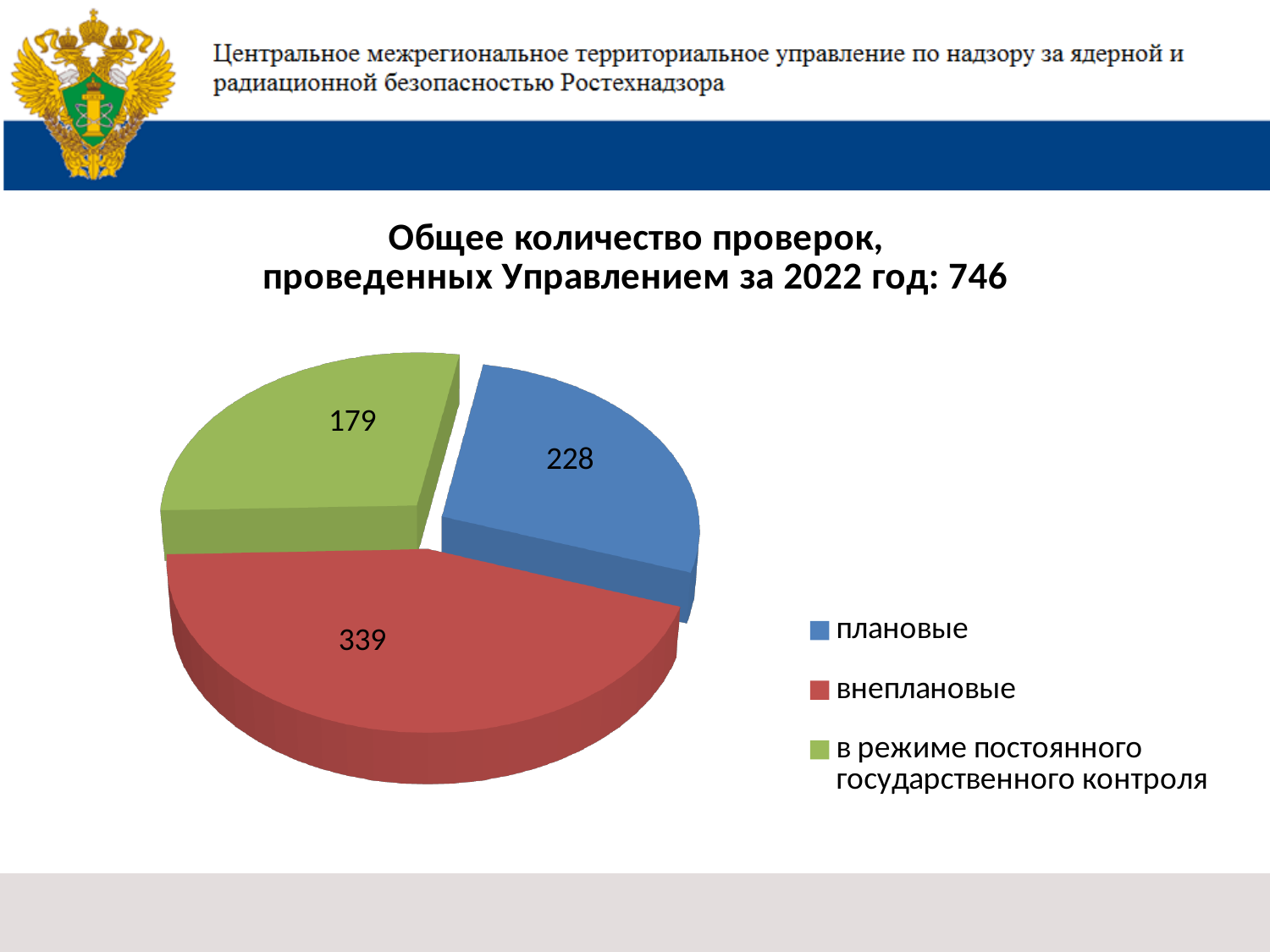
What is the difference between the values for внеплановые and плановые? 111 How many entries does the legend list? 3 What total number of inspections for 2022 is stated in the chart title? 746 What is the value for плановые? 228 Which is larger, плановые or в режиме постоянного государственного контроля? плановые How many slices does the pie chart have? 3 What colour is the slice for внеплановые? red Which category has the largest slice? внеплановые What kind of chart is shown on the slide? pie chart Which category has the smallest slice? в режиме постоянного государственного контроля What is the value for внеплановые? 339 What is the value for в режиме постоянного государственного контроля? 179